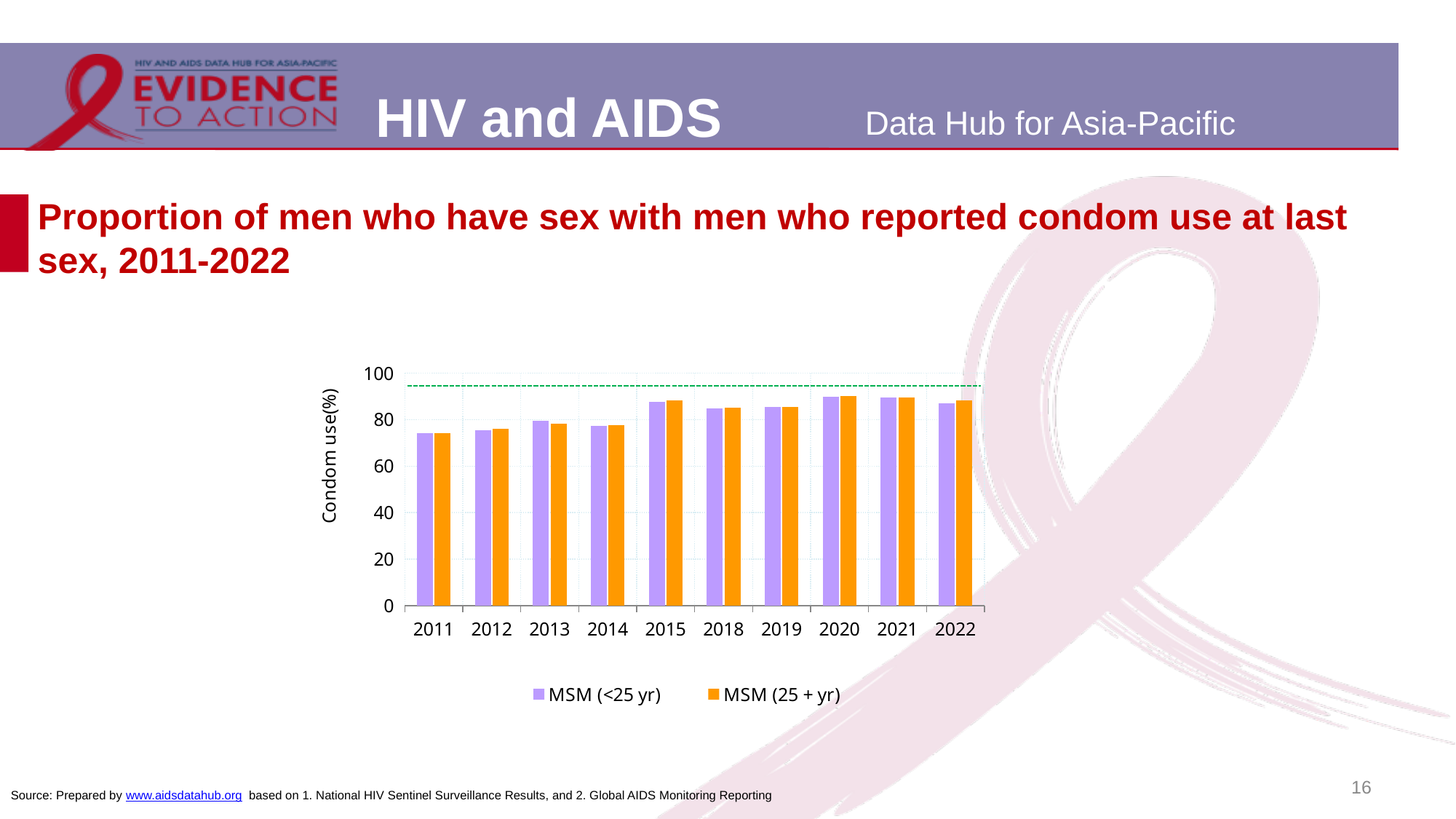
Is the value for MSM (25 + yr) in 2022 greater or less than 60? greater What is the label on the chart's y axis? Condom use(%) Is the value for MSM (<25 yr) in 2020 greater or less than 80? greater How many years are shown on the x axis of the chart? 10 Do the condom use values generally rise or fall from 2011 to 2022? Rise What kind of chart is shown on the slide? Bar chart Is the value for MSM (25 + yr) in 2015 greater or less than 80? greater For MSM (<25 yr), which year has the larger value, 2011 or 2020? 2020 How many series does the chart's legend list? 2 For MSM (25 + yr), which year has the larger value, 2012 or 2015? 2015